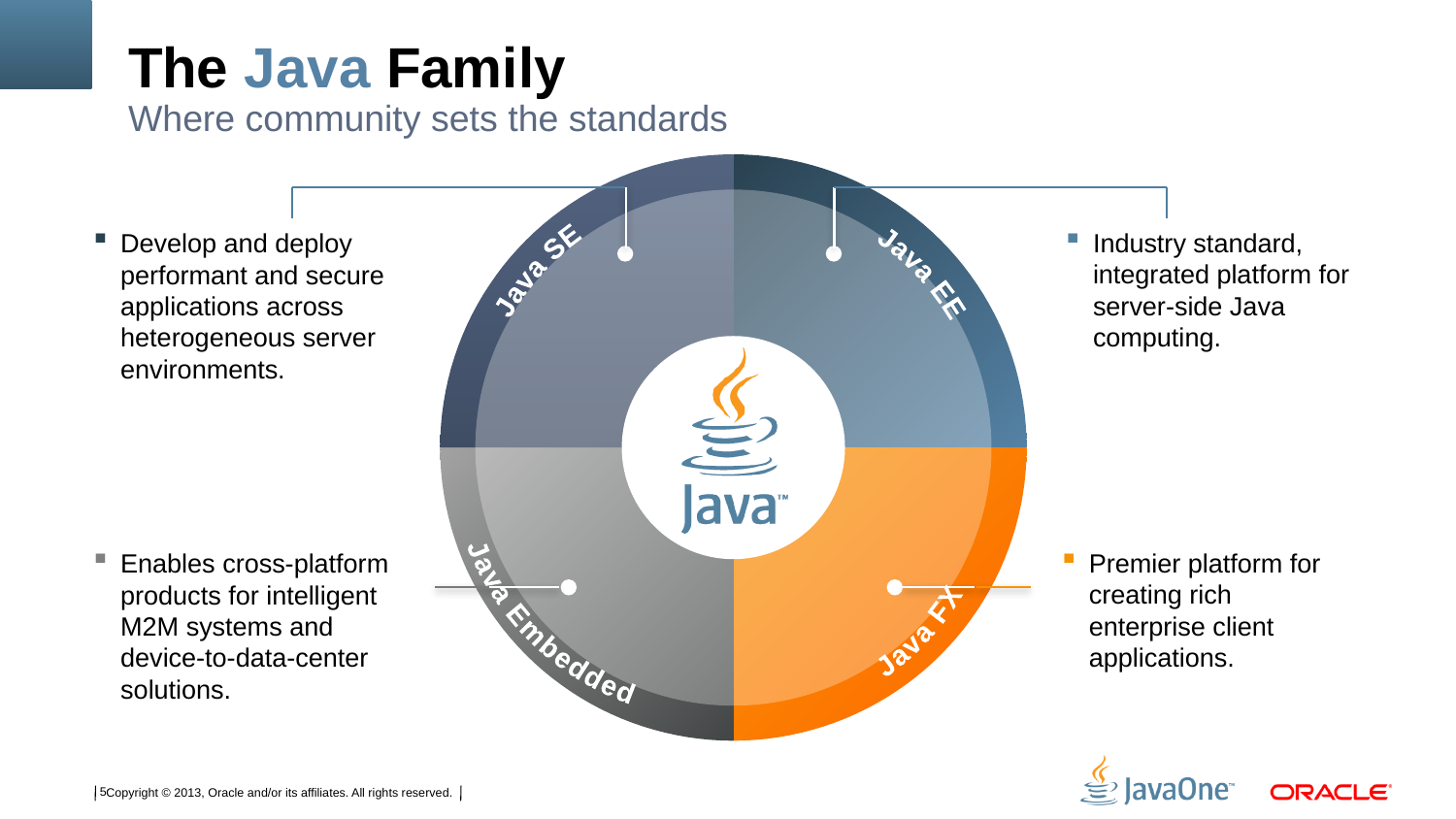
What label is on the bottom-left segment of the circular diagram? Java Embedded What label is on the top-right segment of the circular diagram? Java EE How many segments does the circular diagram in the centre of the slide have? 4 What word appears in the centre of the circular diagram? Java What label is on the top-left segment of the circular diagram? Java SE Which segment of the circular diagram is coloured orange? Java FX